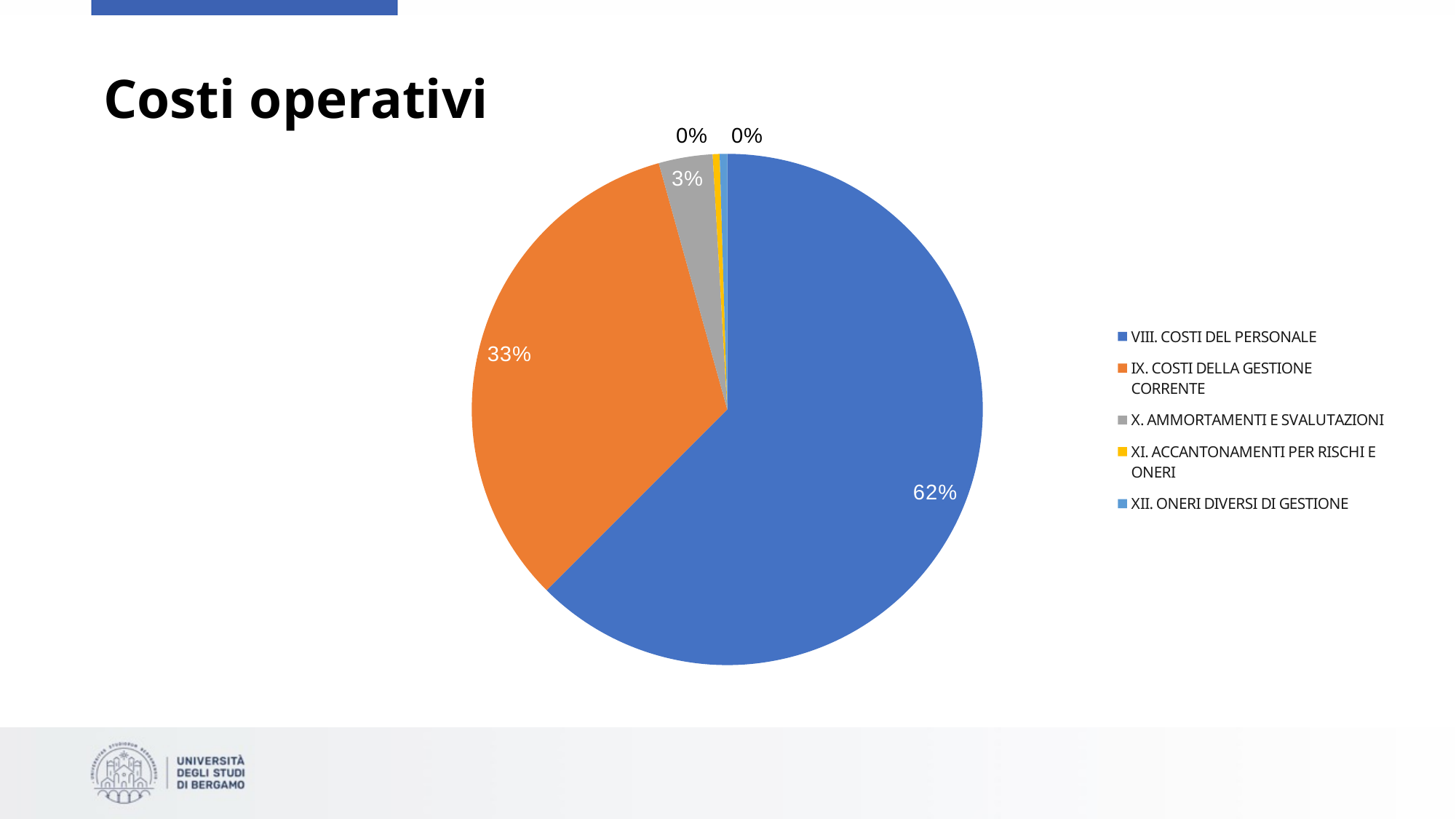
Which is larger, the slice for IX. COSTI DELLA GESTIONE CORRENTE or the slice for X. AMMORTAMENTI E SVALUTAZIONI? IX. COSTI DELLA GESTIONE CORRENTE What percentage is shown for XI. ACCANTONAMENTI PER RISCHI E ONERI? 0% How many categories does the legend list? 5 What share of the pie does VIII. COSTI DEL PERSONALE represent? 62% Which category has the largest slice of the pie? VIII. COSTI DEL PERSONALE What is the difference in percentage points between VIII. COSTI DEL PERSONALE and IX. COSTI DELLA GESTIONE CORRENTE? 29 percentage points What colour is the slice for IX. COSTI DELLA GESTIONE CORRENTE? orange What kind of chart is shown on the slide? pie chart What share of the pie does IX. COSTI DELLA GESTIONE CORRENTE represent? 33% What is the title of the slide containing the chart? Costi operativi What share of the pie does X. AMMORTAMENTI E SVALUTAZIONI represent? 3% What percentage is shown for XII. ONERI DIVERSI DI GESTIONE? 0%